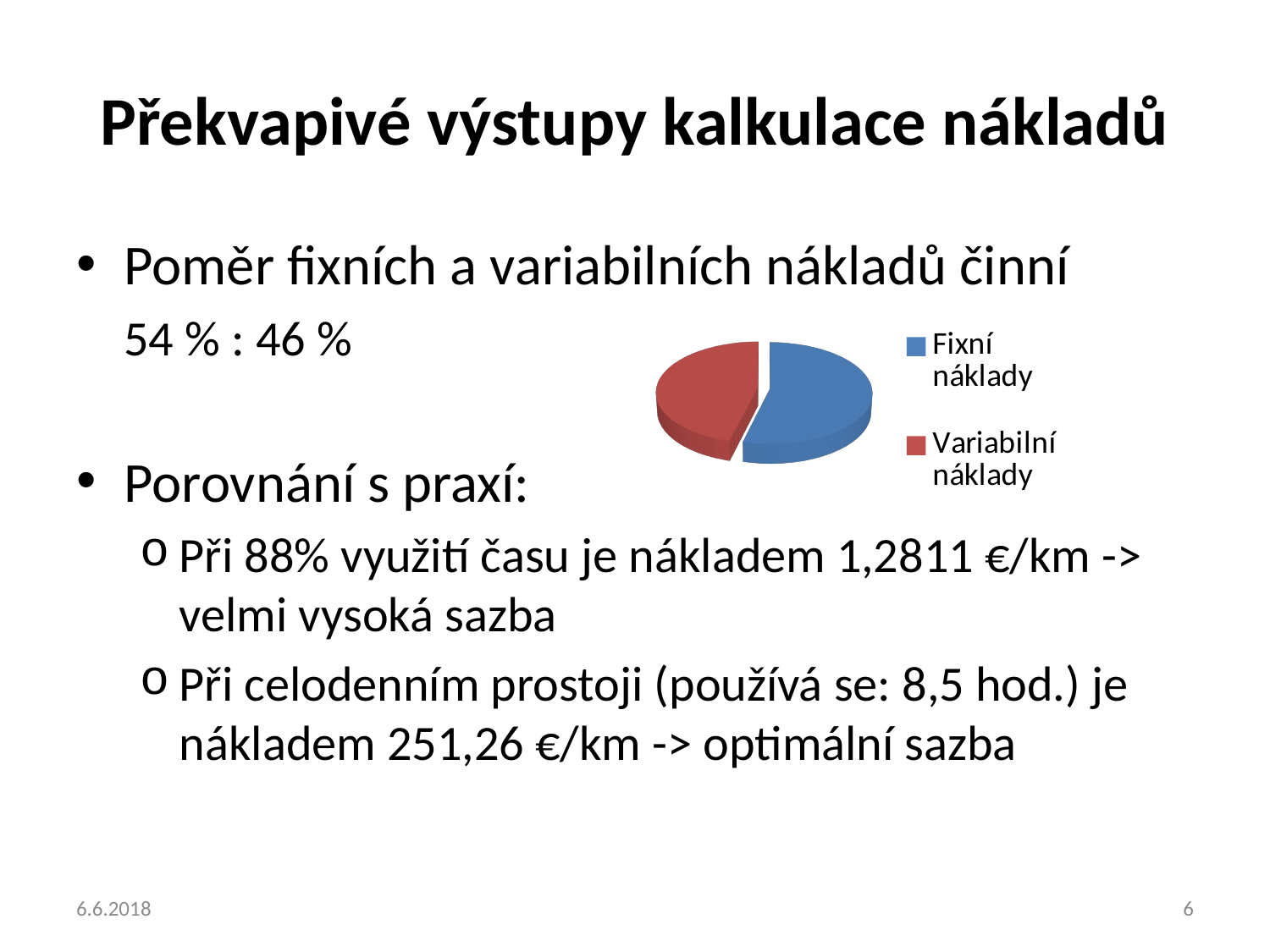
What share of the pie does Variabilní náklady represent, according to the slide? 46 % Which slice of the pie chart is the largest? Fixní náklady How many entries does the legend of the pie chart list? 2 Which slice of the pie chart is the smallest? Variabilní náklady Which is larger in the pie chart, Fixní náklady or Variabilní náklady? Fixní náklady What kind of chart is shown on the slide? pie chart What colour is the Variabilní náklady slice in the pie chart? red What share of the pie does Fixní náklady represent, according to the slide? 54 % How many slices does the pie chart have? 2 What colour is the Fixní náklady slice in the pie chart? blue